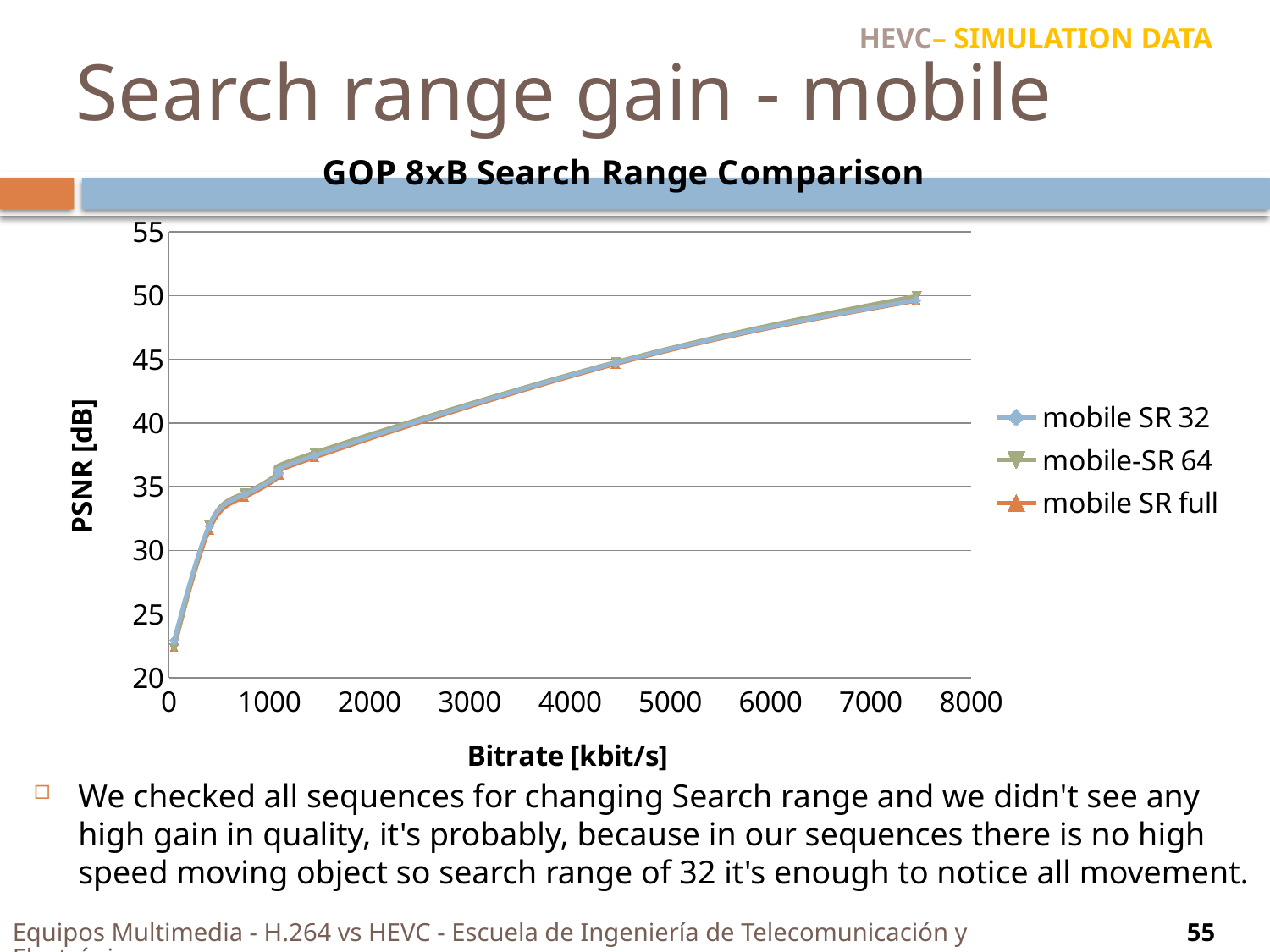
Does PSNR rise or fall as bitrate increases along the x axis? rise Is the PSNR value for mobile SR full at the point near 1500 kbit/s greater or less than 35? greater Is the PSNR value for mobile-SR 64 at its highest bitrate point greater or less than 55? less Is the PSNR value for mobile SR 32 at its highest bitrate point greater or less than 45? greater What is the title of the chart? GOP 8xB Search Range Comparison What is the label of the vertical axis? PSNR [dB] How many series does the legend list? 3 What kind of chart is shown on the slide? line chart